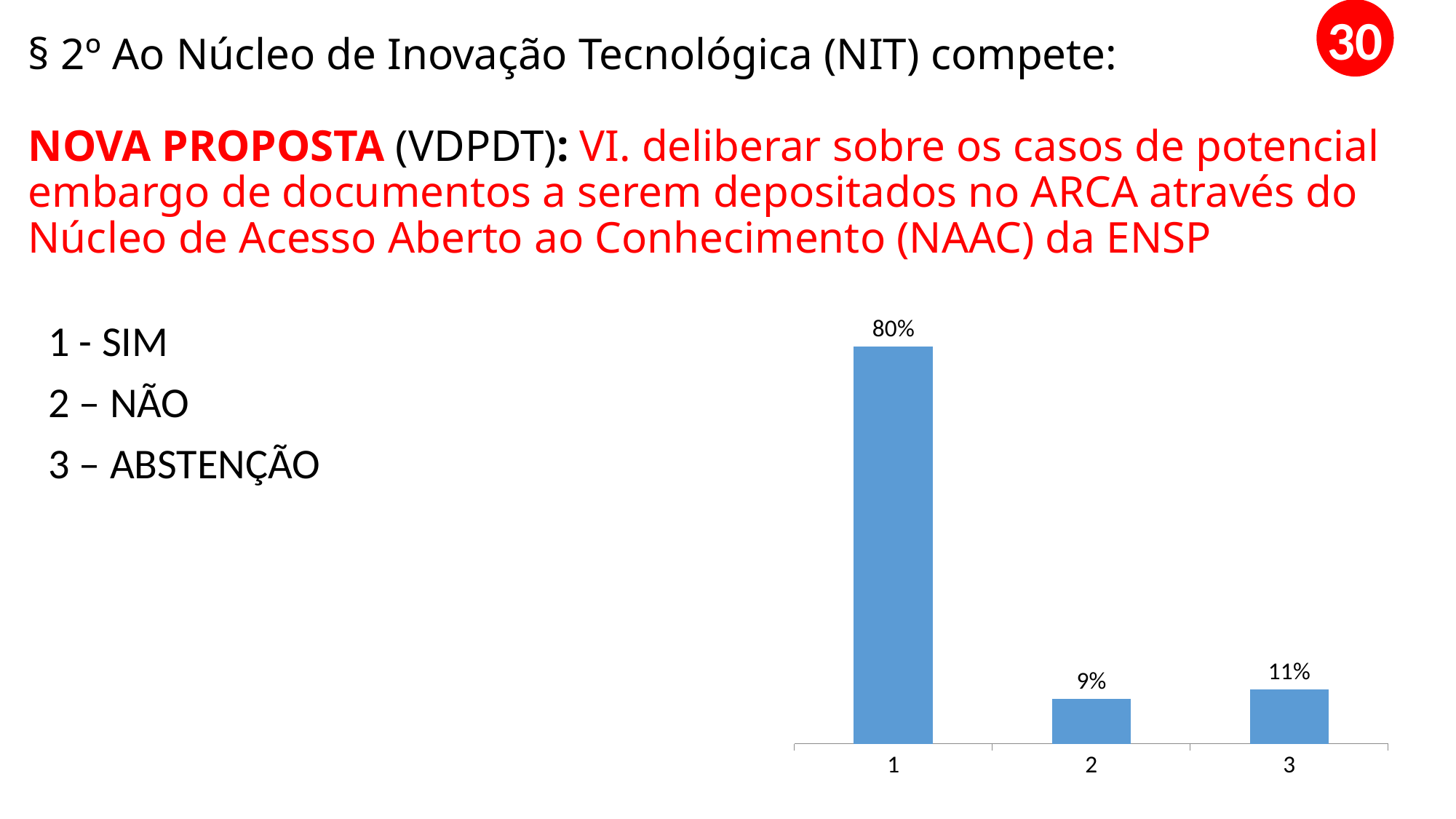
What is the value shown for category 1 in the bar chart? 80% What is the difference between the values for category 3 and category 2? 2% What is the difference between the values for category 1 and category 3? 69% What is the value shown for category 3 in the bar chart? 11% What kind of chart is shown on the slide? bar chart Which category has the highest value in the bar chart? 1 How many categories are shown on the x axis of the bar chart? 3 Which is larger, the value for category 2 or the value for category 3? 3 What is the value shown for category 2 in the bar chart? 9% Which category has the lowest value in the bar chart? 2 What is the total of the three values shown in the bar chart? 100% What colour are the bars in the chart? blue